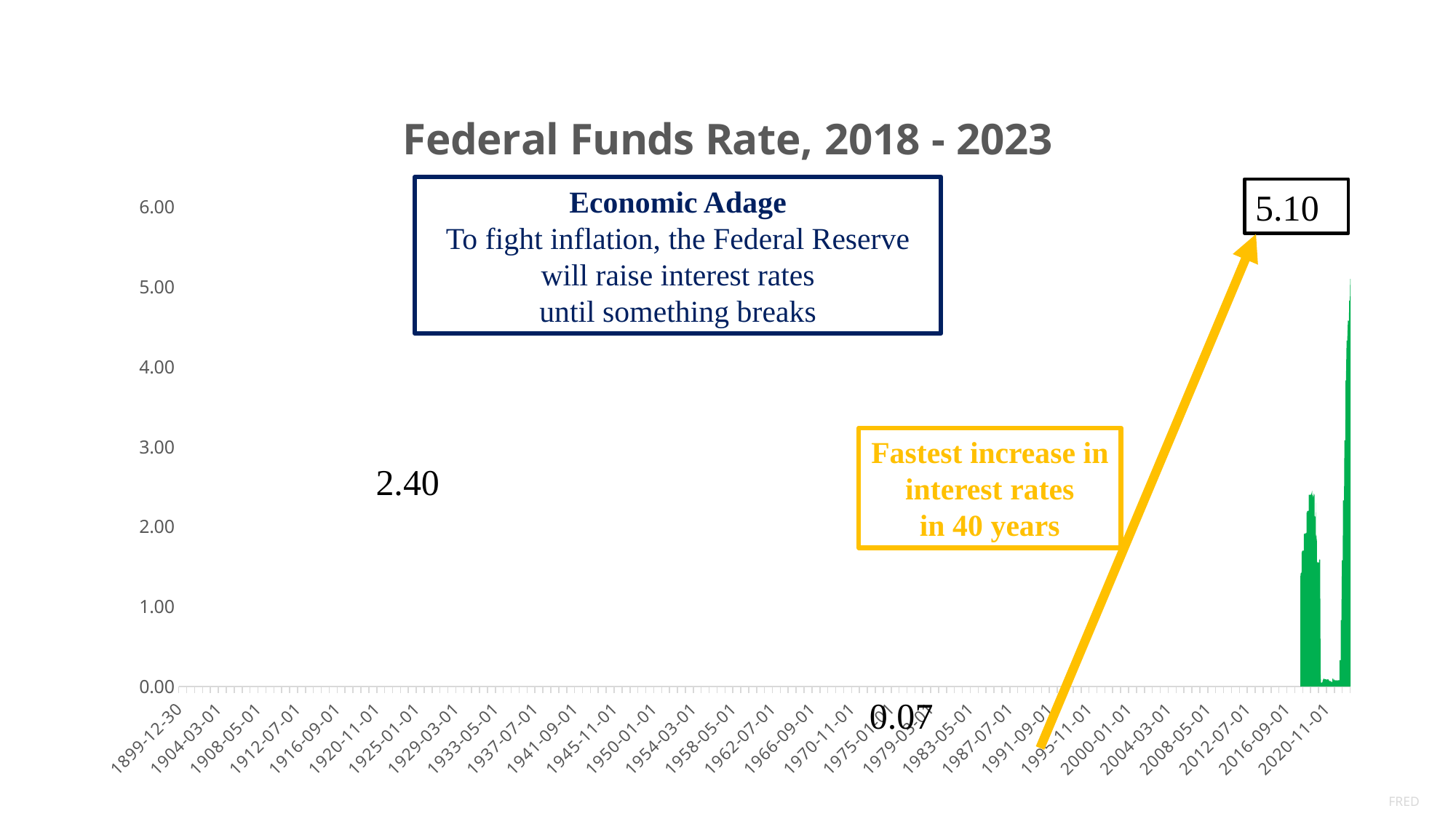
Does the Federal Funds Rate rise or fall from 2019 into 2020 on the chart? fall What is the difference between the labelled peak value of 5.10 and the labelled low of 0.07? 5.03 What is the title of the chart? Federal Funds Rate, 2018 - 2023 Does the Federal Funds Rate rise or fall from 2022 into 2023 on the chart? rise What does the yellow text box on the chart say? Fastest increase in interest rates in 40 years What is the difference between the labelled values 5.10 and 2.40? 2.70 Is the earlier peak of the Federal Funds Rate around 2019 greater or less than 3.00? less Which labelled value is larger, 2.40 or 5.10? 5.10 What kind of chart is shown on the slide? area chart What is the lowest Federal Funds Rate value labelled on the chart? 0.07 Is the peak of the Federal Funds Rate in 2023 greater or less than 4.00? greater What is the highest Federal Funds Rate value labelled on the chart? 5.10